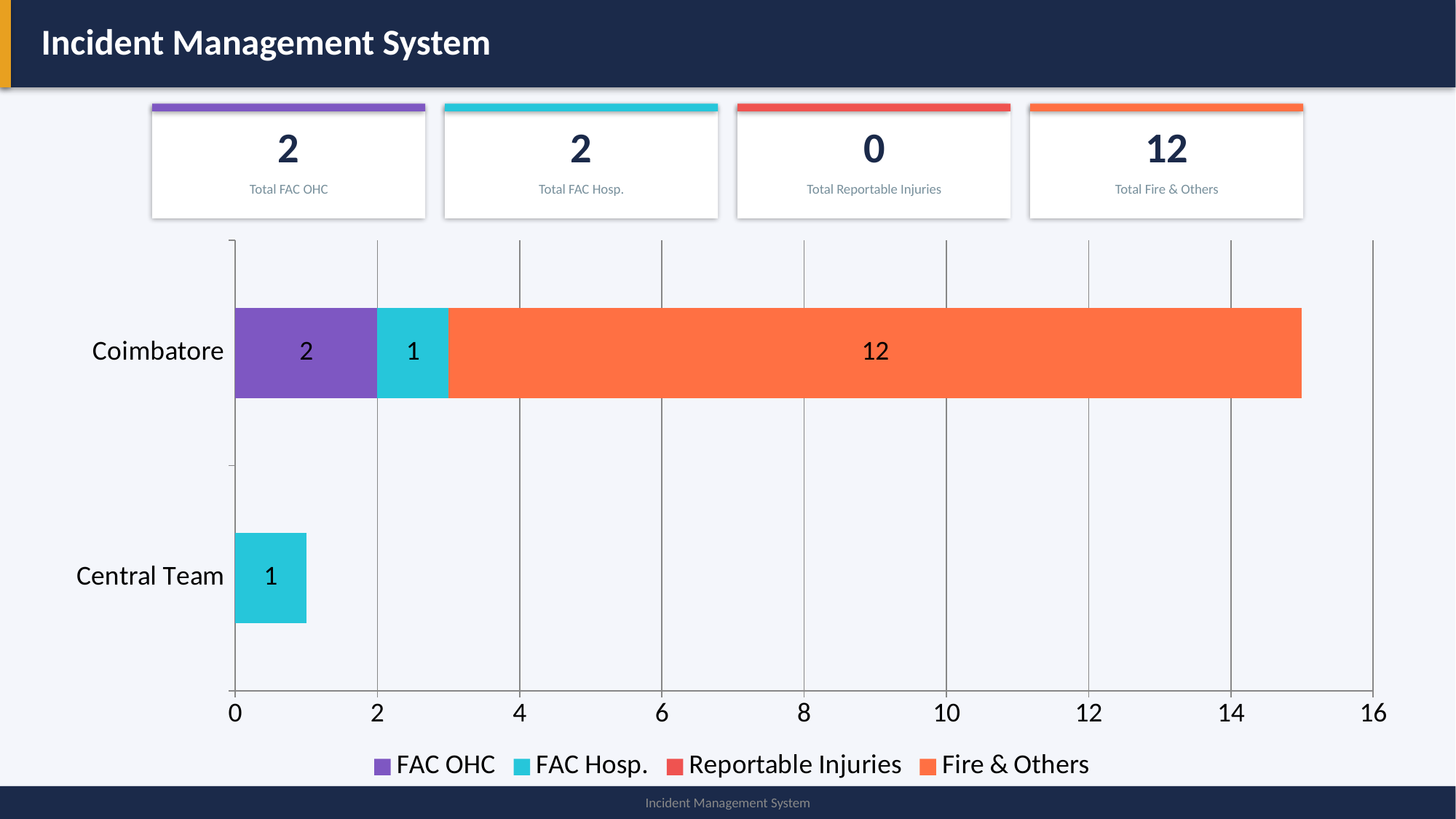
What kind of chart is shown on the slide? Stacked bar chart What is the difference between the Fire & Others value and the FAC OHC value for Coimbatore? 10 Which category has the longer stacked bar, Coimbatore or Central Team? Coimbatore What is the total of the stacked bar for Coimbatore? 15 What is the Fire & Others value for Coimbatore? 12 What is the FAC Hosp. value for Coimbatore? 1 How many series does the legend list? 4 What is the FAC OHC value for Coimbatore? 2 How many categories are shown on the y axis of the chart? 2 Is the total stacked bar for Coimbatore greater or less than 14? greater Which series in the legend is shown in orange? Fire & Others What is the FAC Hosp. value for Central Team? 1